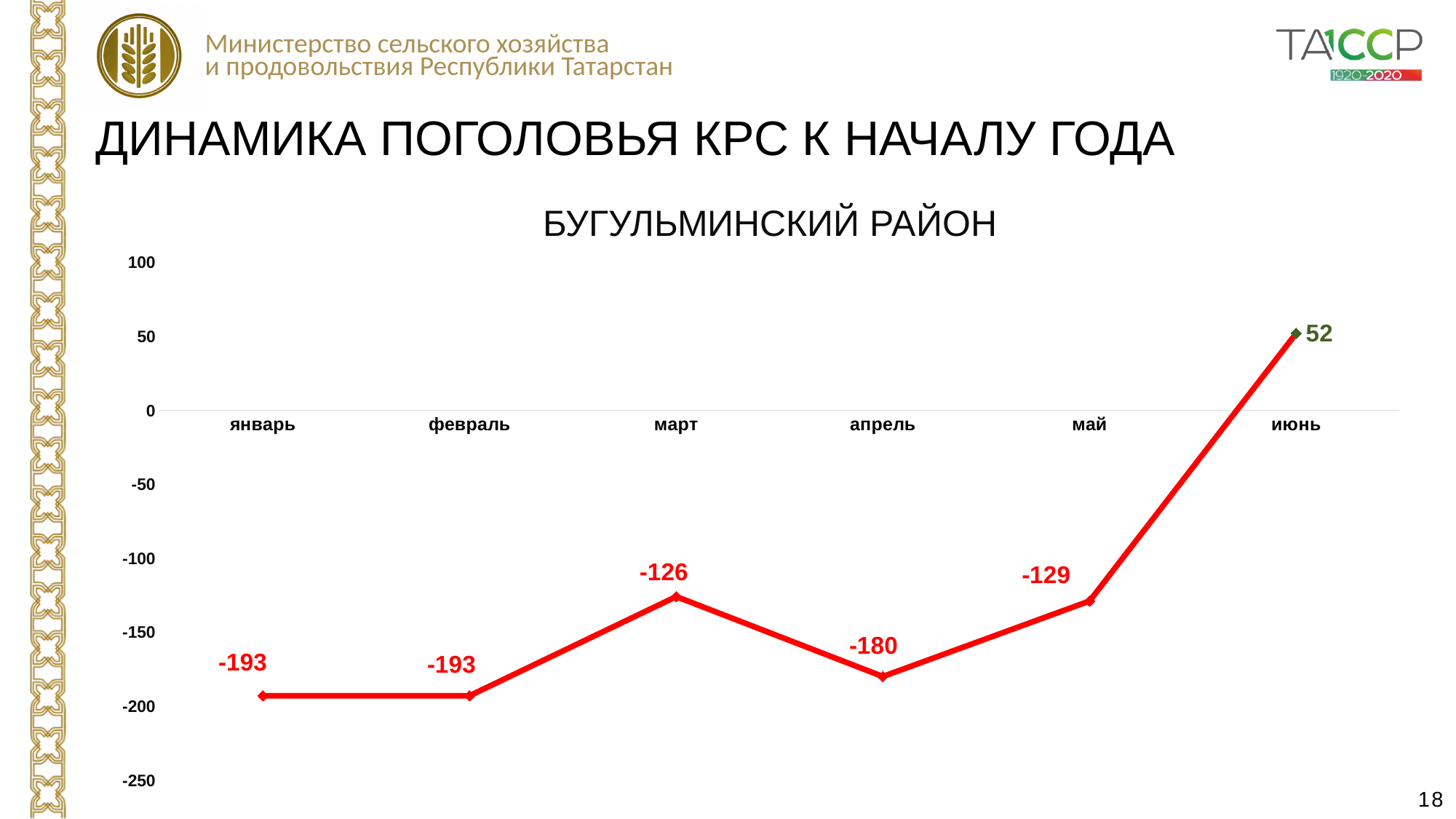
Is the value for апрель greater or less than -150? less Which month has the highest value? июнь What is the value for март (March)? -126 What is the title of the chart? БУГУЛЬМИНСКИЙ РАЙОН How many months are plotted on the chart? 6 What kind of chart is shown? line chart Does the value rise or fall from май to июнь? rise Which is larger, the value for март or the value for май? март What is the value for июнь (June)? 52 What is the value for апрель (April)? -180 Which month has the lowest value, excluding ties? Name the months that share the lowest value. январь and февраль What is the difference between the values for май and апрель? 51